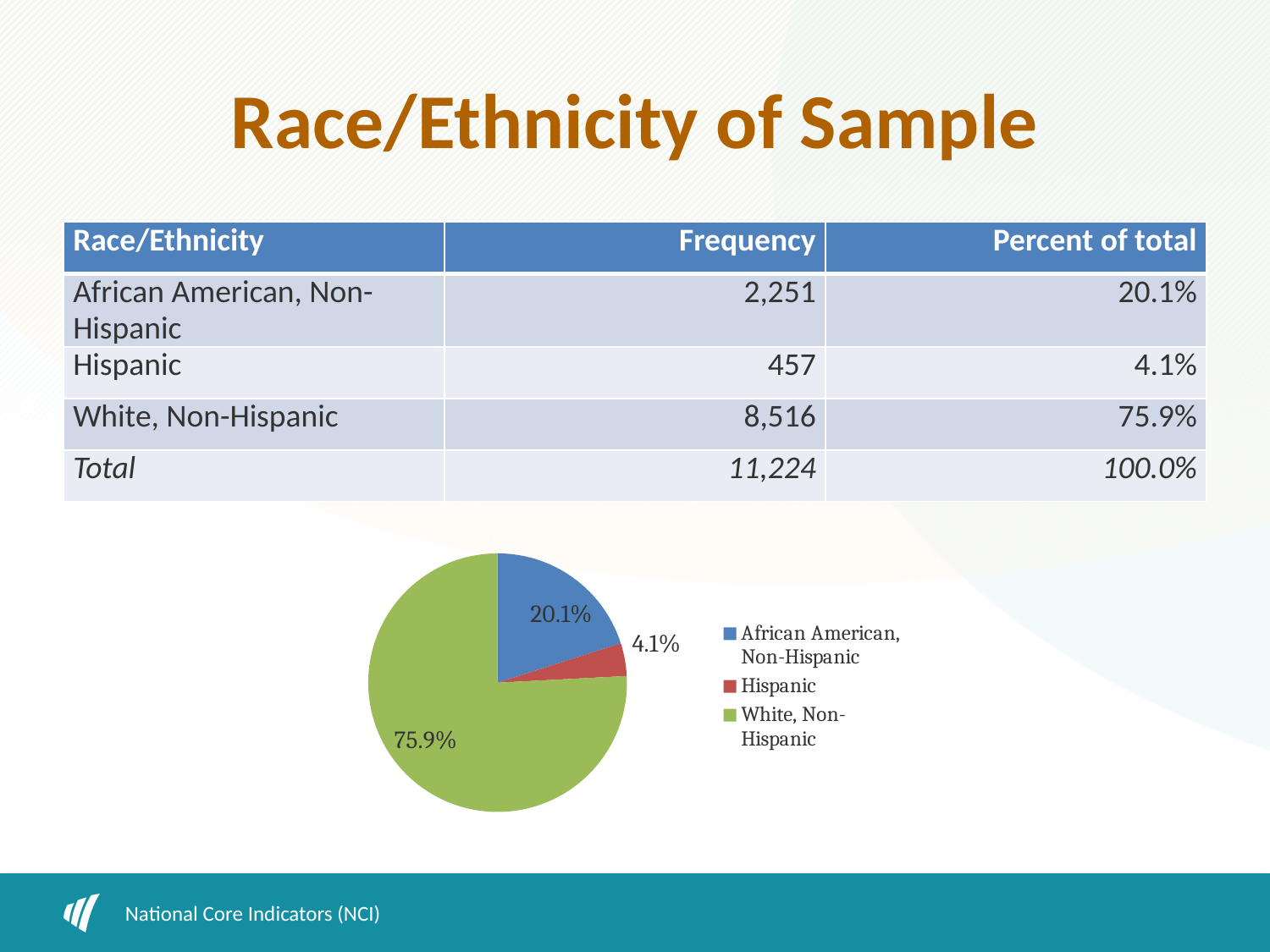
What share of the pie does the African American, Non-Hispanic slice represent? 20.1% How many entries does the legend list? 3 Which category has the largest slice of the pie? White, Non-Hispanic What share of the pie does the Hispanic slice represent? 4.1% Which slice is larger: African American, Non-Hispanic or Hispanic? African American, Non-Hispanic What is the difference in percentage points between the White, Non-Hispanic slice and the African American, Non-Hispanic slice? 55.8 What share of the pie does the White, Non-Hispanic slice represent? 75.9% Which category has the smallest slice of the pie? Hispanic What colour is the Hispanic slice in the pie chart? Red What colour is the White, Non-Hispanic slice in the pie chart? Green What kind of chart is shown on the slide? Pie chart How many slices does the pie chart have? 3